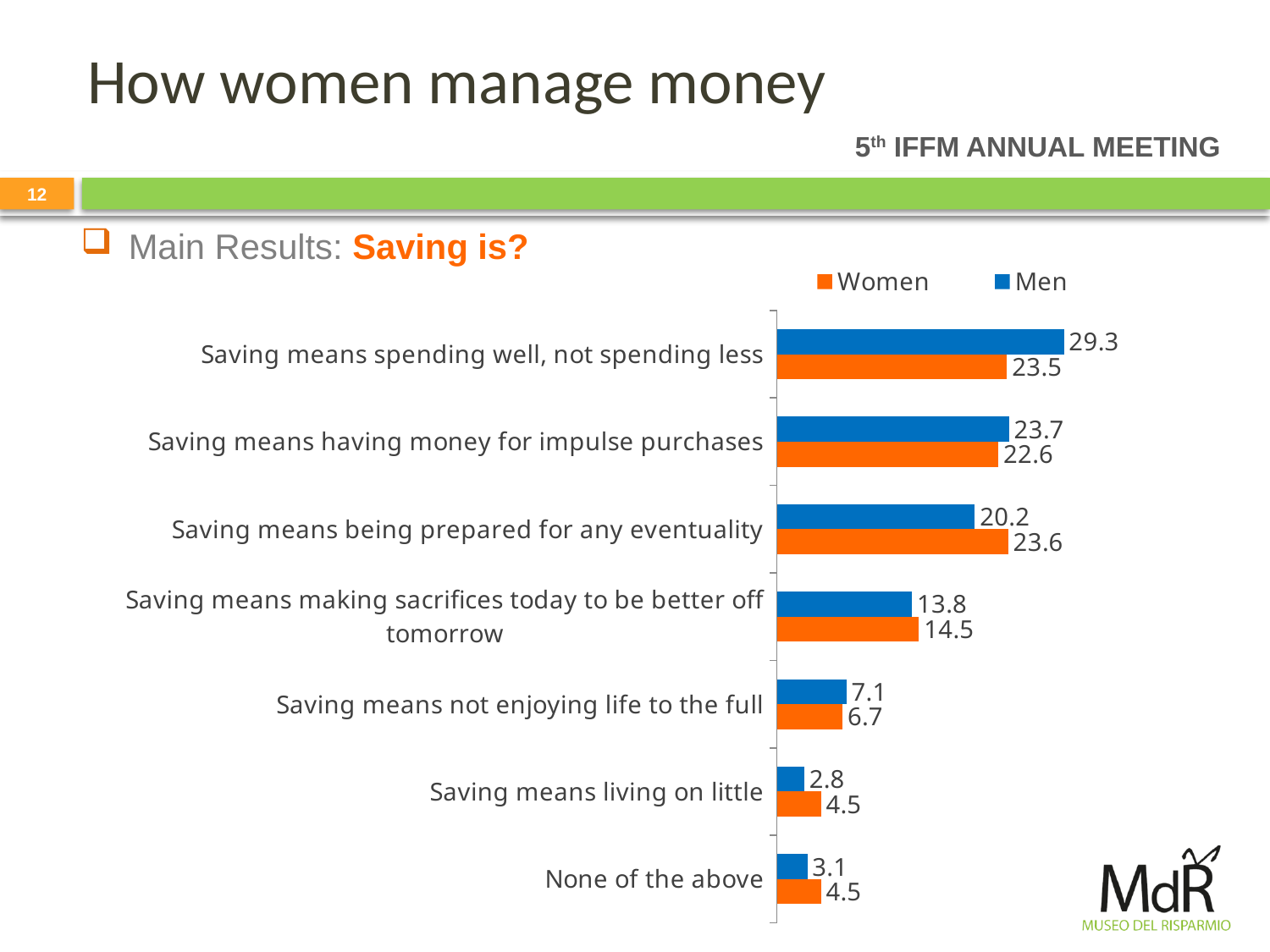
How many series does the legend list? 2 For "Saving means making sacrifices today to be better off tomorrow", which is larger, the Women value or the Men value? Women What is the difference between the Women and Men values for "Saving means being prepared for any eventuality"? 3.4 What kind of chart is shown on the slide? Bar chart What is the difference between the Men and Women values for "Saving means spending well, not spending less"? 5.8 What is the value for Men for "Saving means spending well, not spending less"? 29.3 For "Saving means not enjoying life to the full", which is larger, the Women value or the Men value? Men Which category has the lowest value for Men? Saving means living on little Which category has the highest value for Men? Saving means spending well, not spending less What is the value for Women for "Saving means being prepared for any eventuality"? 23.6 What is the value for Women for "Saving means living on little"? 4.5 How many categories are shown in the chart? 7